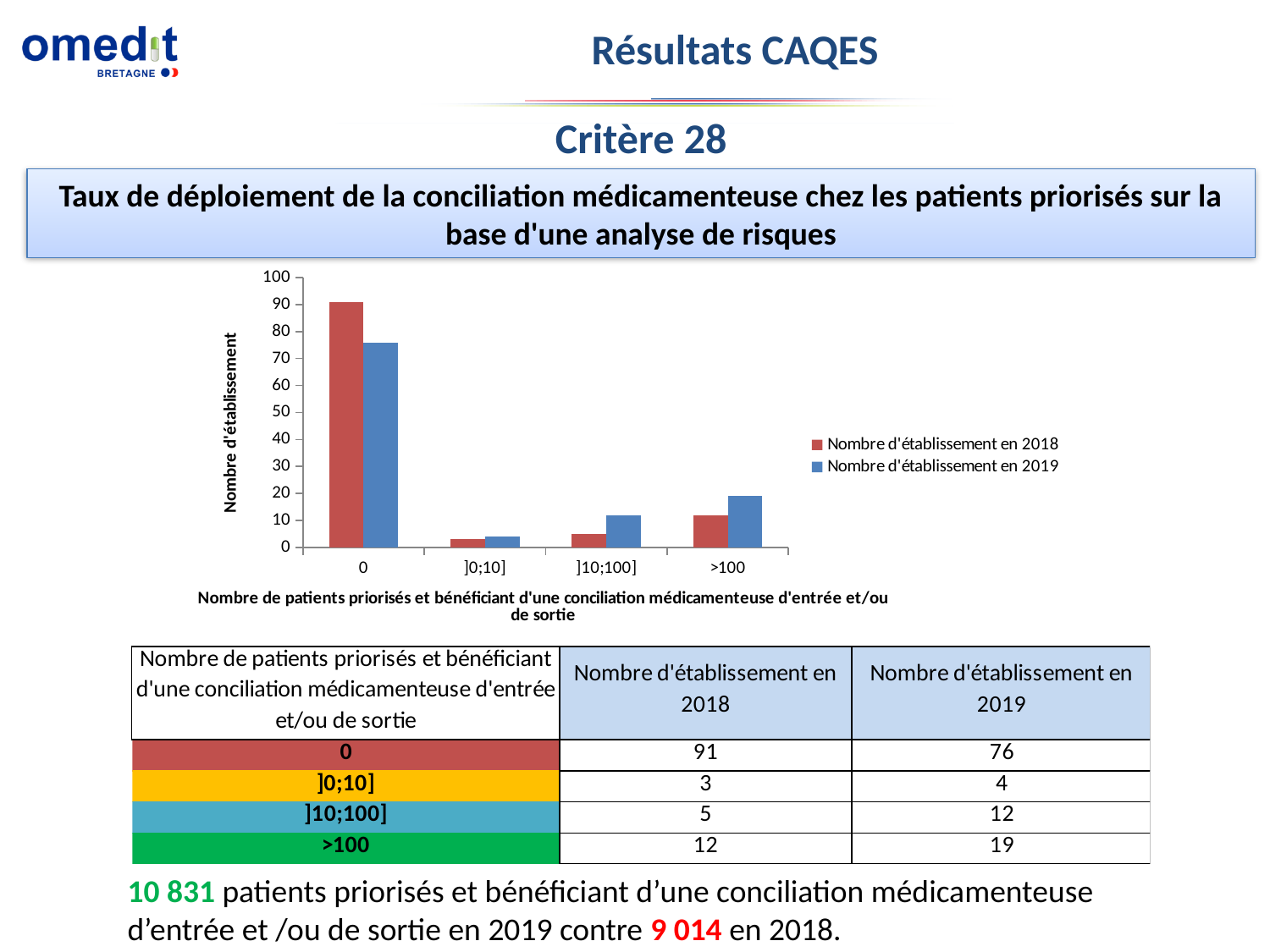
What is the value for the category >100 in the series Nombre d'établissement en 2019? 19 What is the difference between the 2018 and 2019 values for the category 0? 15 What colour are the bars for the series Nombre d'établissement en 2018? red Which category has the highest value in the series Nombre d'établissement en 2019? 0 What kind of chart is shown on the slide? bar chart How many series does the chart legend list? 2 How many categories are shown on the x axis of the chart? 4 Which category has the lowest value in the series Nombre d'établissement en 2018? ]0;10] What is the value for the category 0 in the series Nombre d'établissement en 2018? 91 Is the value for the category 0 in the series Nombre d'établissement en 2019 greater or less than 70? greater What is the value for the category ]10;100] in the series Nombre d'établissement en 2019? 12 For the category >100, which series has the larger value, Nombre d'établissement en 2018 or Nombre d'établissement en 2019? Nombre d'établissement en 2019